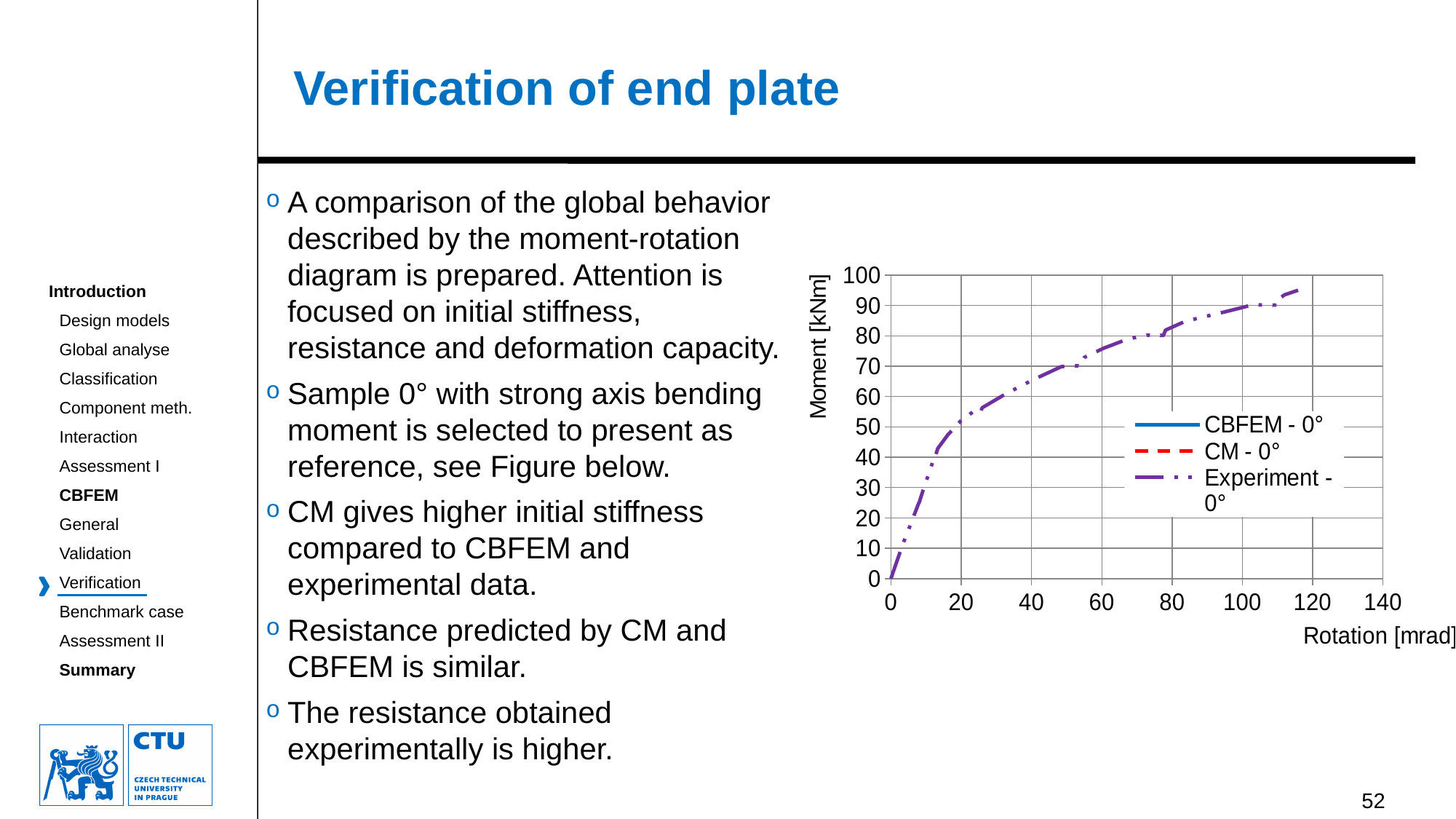
Does the Experiment - 0° curve rise or fall as rotation increases? rise What is the label of the vertical axis of the chart? Moment [kNm] What is the largest value shown on the horizontal (Rotation) axis of the chart? 140 What kind of chart is shown on the slide? line chart Is the highest moment reached by the Experiment - 0° curve greater or less than 90 kNm? greater Is the moment of the Experiment - 0° curve at a rotation of 20 mrad greater or less than 40 kNm? greater Is the moment of the Experiment - 0° curve at a rotation of 40 mrad greater or less than 80 kNm? less How many series does the chart legend list? 3 What is the label of the horizontal axis of the chart? Rotation [mrad] What is the largest value shown on the vertical (Moment) axis of the chart? 100